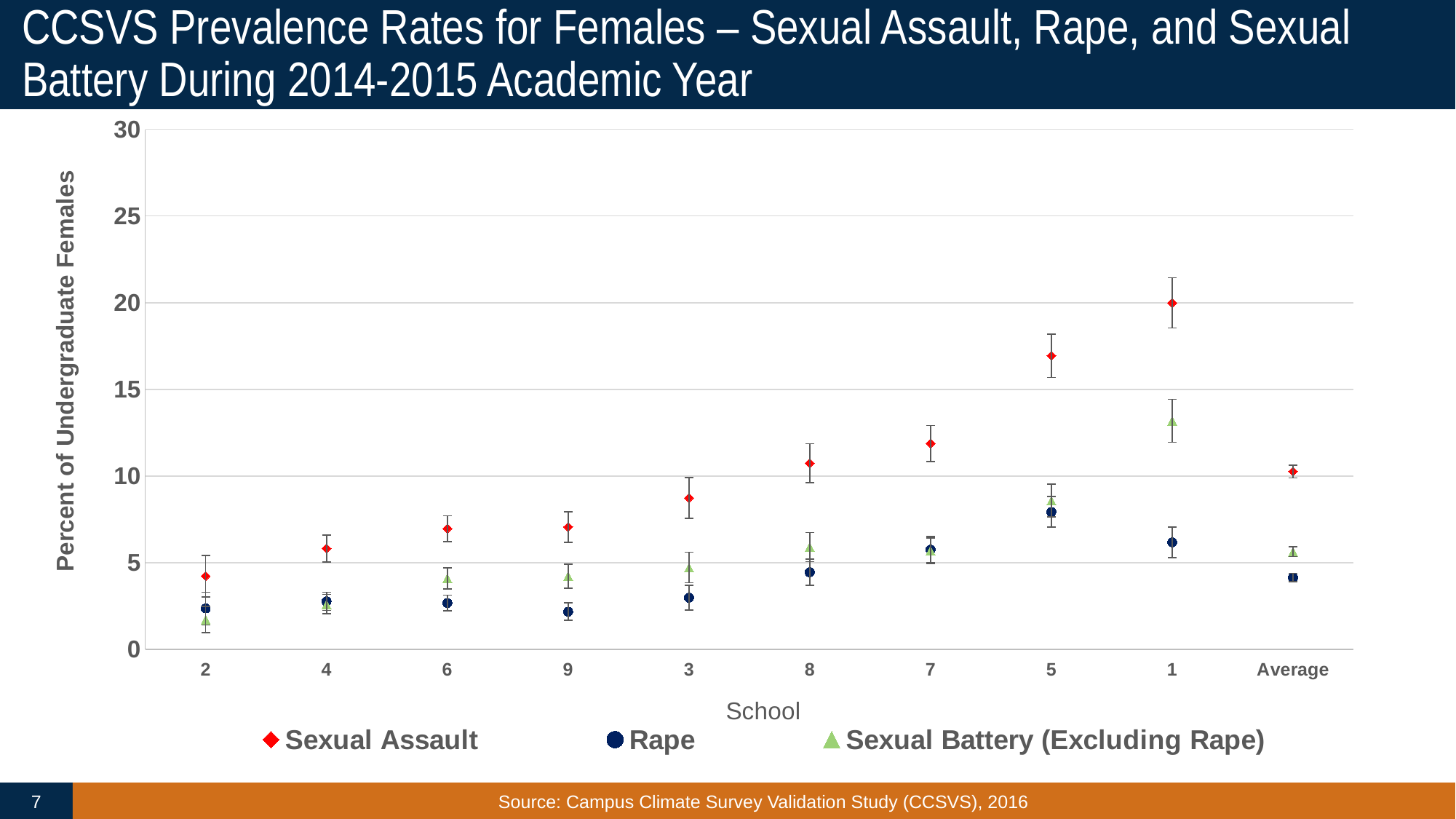
How many series does the legend list? 3 Which school has the highest Sexual Assault prevalence rate? School 1 At School 1, which is larger: the Rape rate or the Sexual Battery (Excluding Rape) rate? Sexual Battery (Excluding Rape) Do the Sexual Assault values generally rise or fall moving left to right across the schools? rise Which school has the lowest Sexual Assault prevalence rate? School 2 Which school has the highest Sexual Battery (Excluding Rape) rate? School 1 Is the Sexual Assault value for School 2 greater or less than 5? less Is the Sexual Battery (Excluding Rape) value for School 1 greater or less than 10? greater How many categories are shown along the x axis? 10 Is the Sexual Assault value for School 1 greater or less than 15? greater What kind of chart is shown on the slide? Scatter (dot) plot with error bars Which school has the highest Rape prevalence rate? School 5